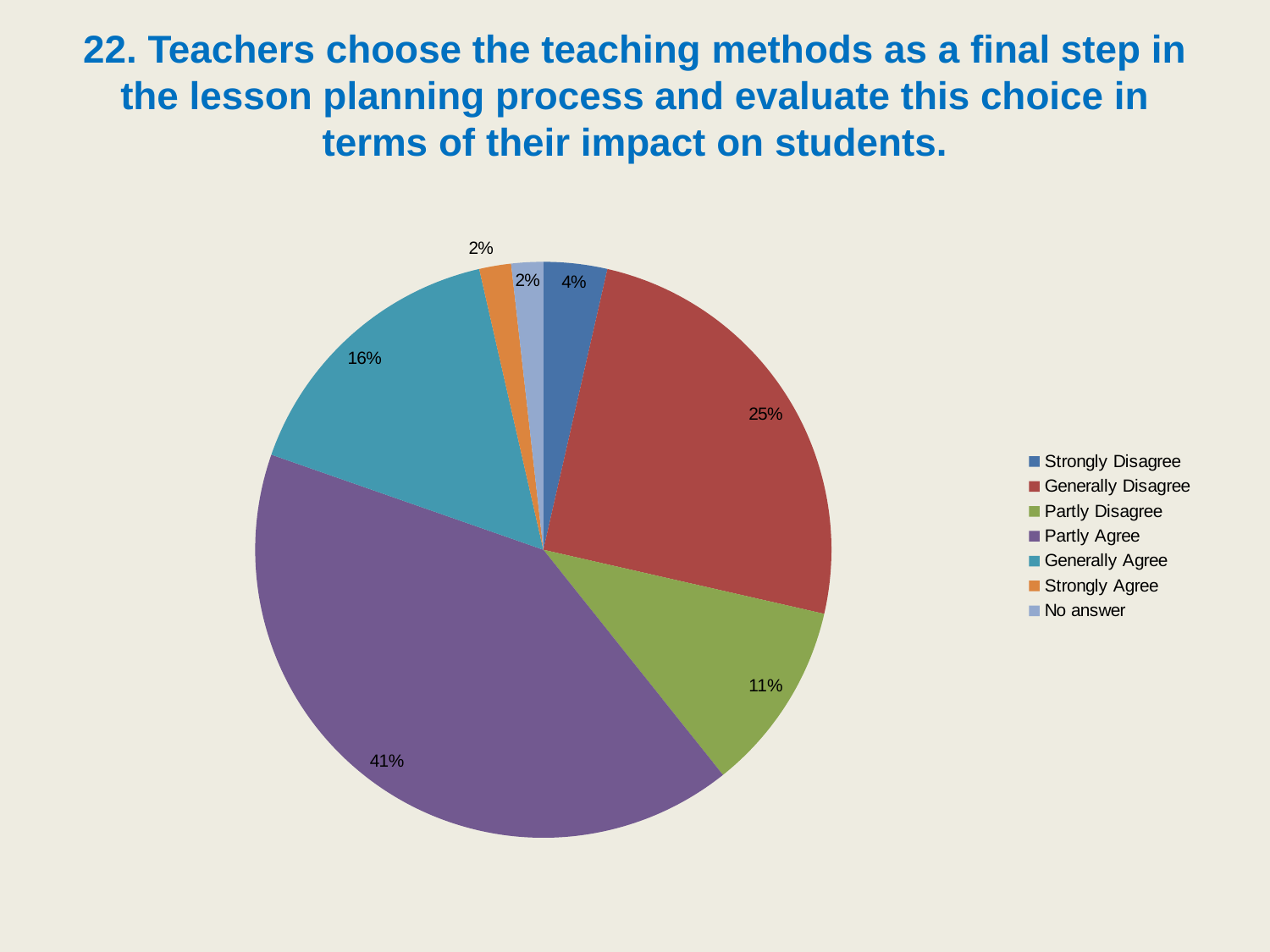
What is the difference between the Generally Disagree and Strongly Disagree shares? 21% What colour is the Partly Agree slice? Purple What is the difference between the Partly Agree and Generally Disagree shares? 16% Which is larger, the share for Generally Agree or the share for Partly Disagree? Generally Agree What kind of chart is shown on the slide? Pie chart What share of the pie does Partly Agree represent? 41% How many categories does the legend list? 7 What is the value shown for Strongly Disagree? 4% Which category has the largest slice of the pie? Partly Agree What is the value shown for Partly Disagree? 11% What is the value shown for Generally Disagree? 25% What is the value shown for Generally Agree? 16%